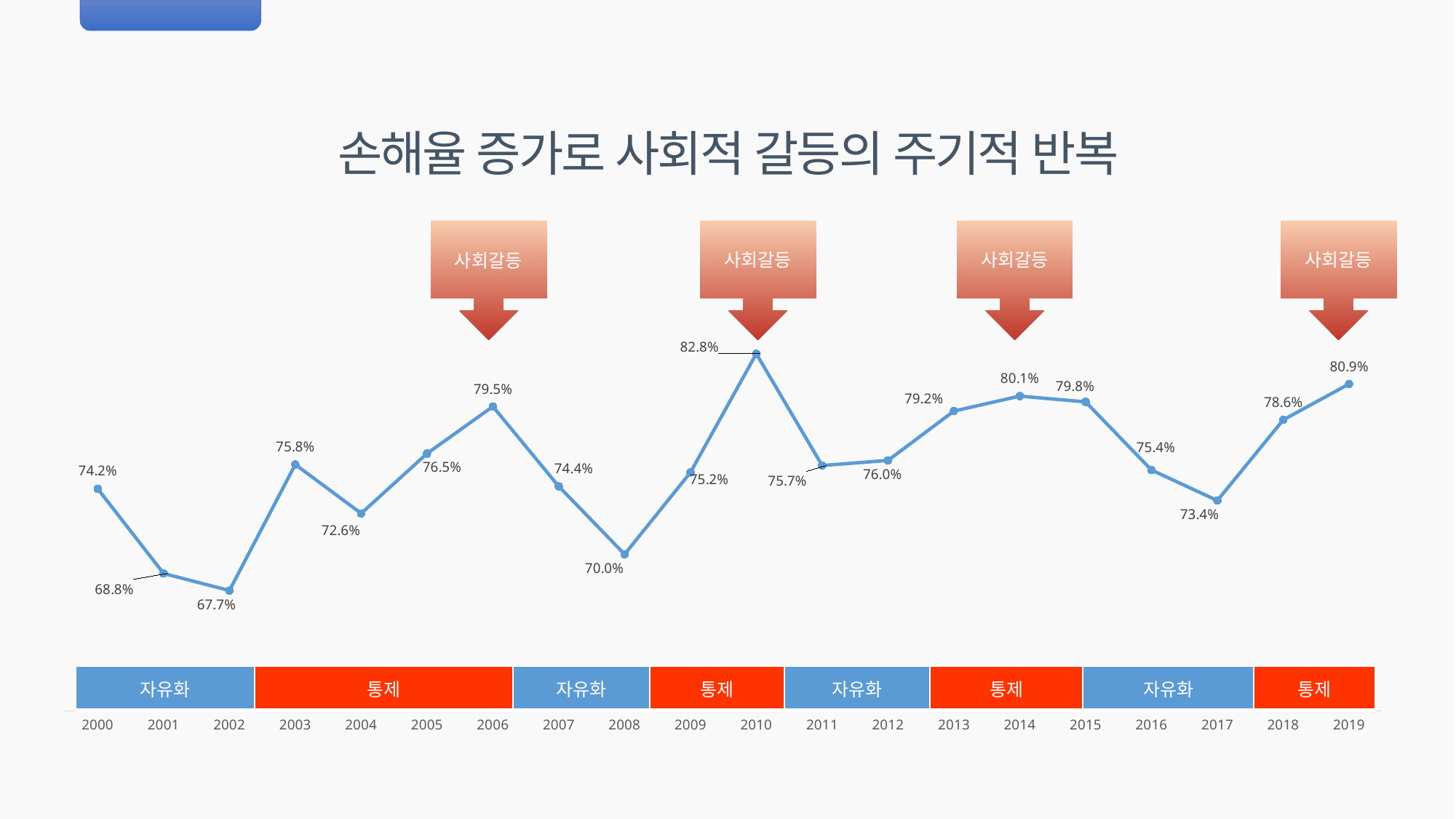
What is the title of the chart? 손해율 증가로 사회적 갈등의 주기적 반복 Which year has the lowest value? 2002 Which is larger, the value for 2006 or the value for 2014? 2014 What kind of chart is shown on the slide? Line chart Which year has the highest value? 2010 What is the difference between the values for 2010 and 2002? 15.1 percentage points What is the value for 2002? 67.7% Does the value rise or fall from 2016 to 2017? Fall What is the value for 2010? 82.8% How many years are plotted on the chart? 20 What is the value for 2019? 80.9% What is the difference between the values for 2019 and 2018? 2.3 percentage points